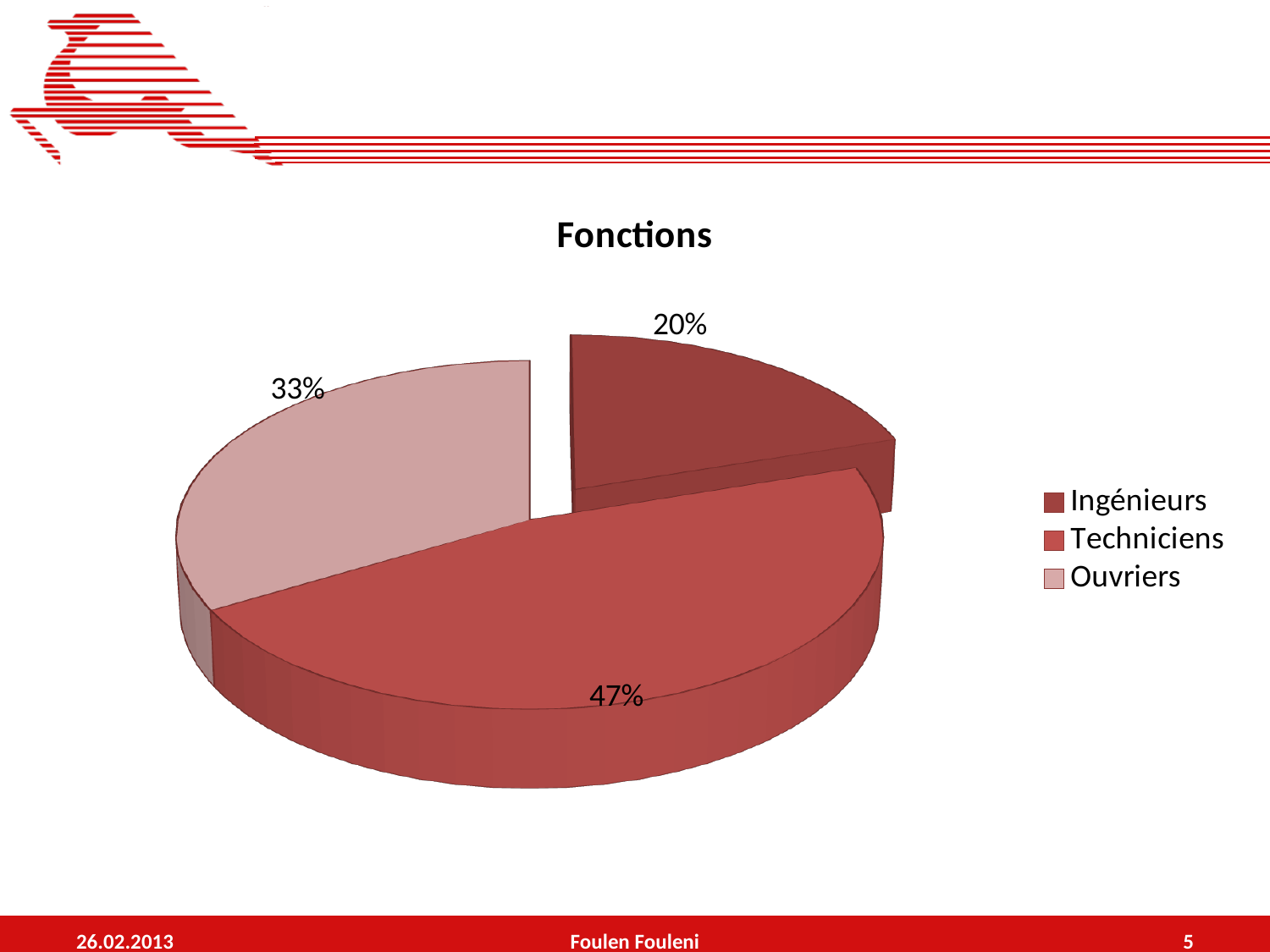
What kind of chart is shown on the slide? pie chart What is the difference in percentage points between Ouvriers and Ingénieurs? 13 How many categories does the pie chart have? 3 How many entries does the legend list? 3 Which category has the largest slice of the pie? Techniciens What share of the pie does Ingénieurs represent? 20% What is the title of the pie chart? Fonctions What share of the pie does Techniciens represent? 47% Which is larger, the share for Ouvriers or the share for Ingénieurs? Ouvriers What share of the pie does Ouvriers represent? 33% Which category has the smallest slice of the pie? Ingénieurs What is the difference in percentage points between Techniciens and Ingénieurs? 27